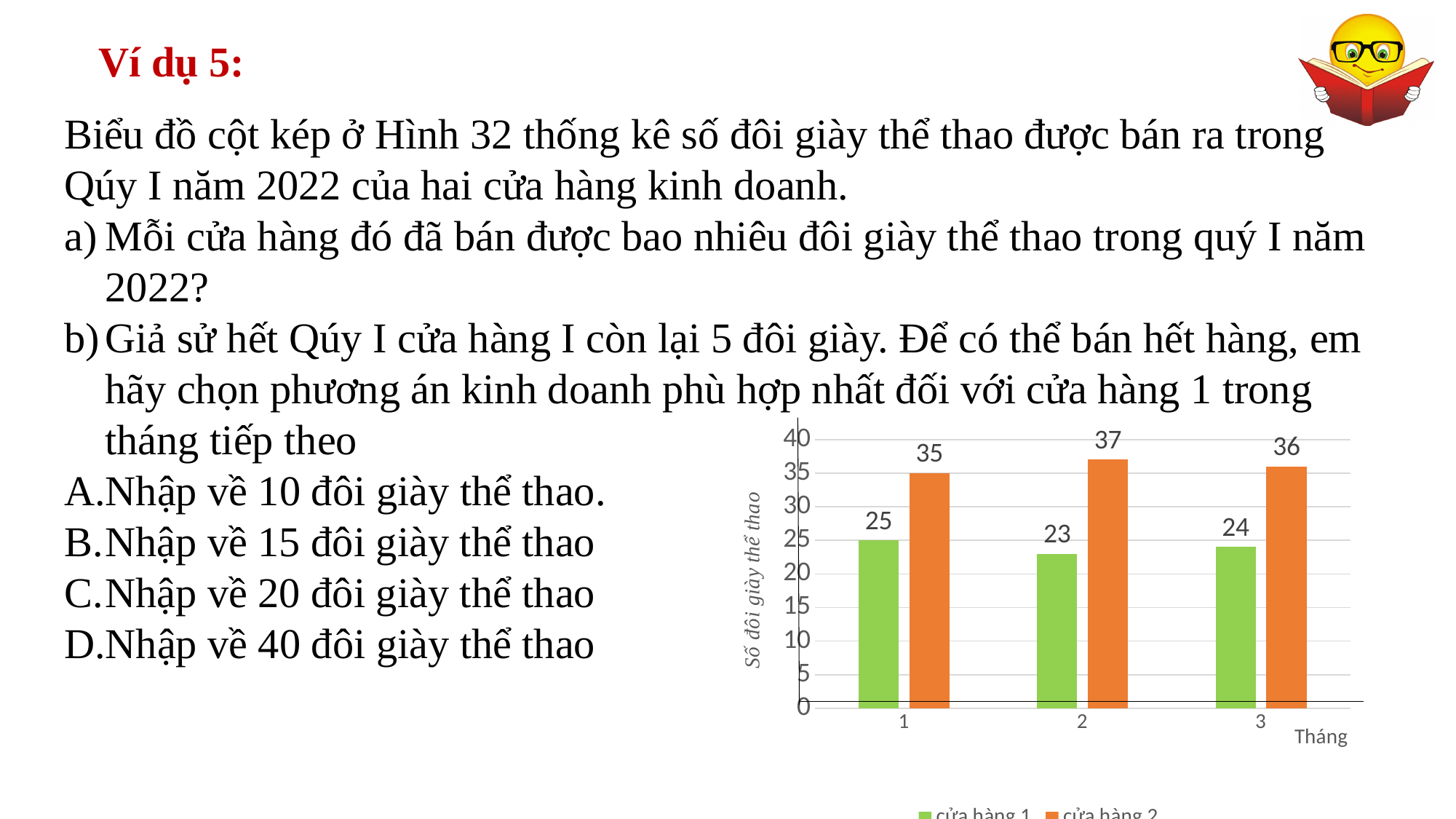
What is the label of the vertical axis? Số đôi giày thể thao How many series does the legend list? 2 What is the value for cửa hàng 1 in month 3? 24 What is the value for cửa hàng 1 in month 1? 25 What is the difference between cửa hàng 2 and cửa hàng 1 in month 1? 10 What kind of chart is shown on the slide? bar chart In which month does cửa hàng 2 have its highest value? 2 What is the value for cửa hàng 2 in month 2? 37 How many months are shown on the x axis? 3 Which is larger in month 3: cửa hàng 1 or cửa hàng 2? cửa hàng 2 In which month does cửa hàng 1 have its lowest value? 2 Is the value for cửa hàng 2 in month 3 greater or less than 30? greater